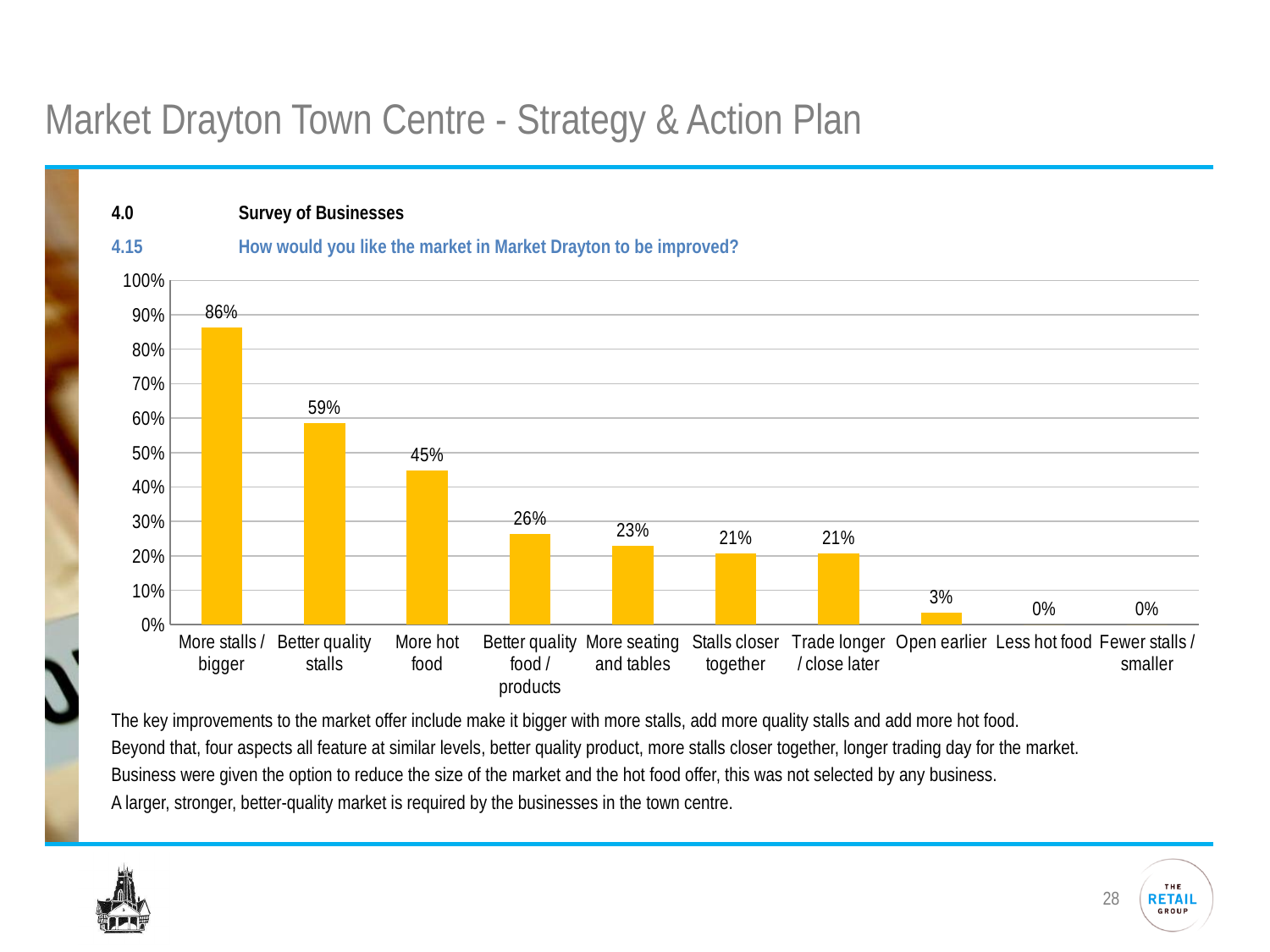
Which is larger, 'More seating and tables' or 'Better quality food / products'? Better quality food / products Do the values rise or fall from left to right along the x axis? Fall What percentage of businesses wanted 'More stalls / bigger'? 86% What is the value for 'More hot food'? 45% Which category has the highest value? More stalls / bigger What is the difference between 'Better quality stalls' and 'More hot food'? 14% Which two categories both have a value of 0%? Less hot food and Fewer stalls / smaller What percentage is shown for 'Open earlier'? 3% What is the difference between 'More stalls / bigger' and 'Better quality food / products'? 60% What kind of chart is this? Bar chart What colour are the bars in the chart? Yellow How many categories are shown on the x axis? 10